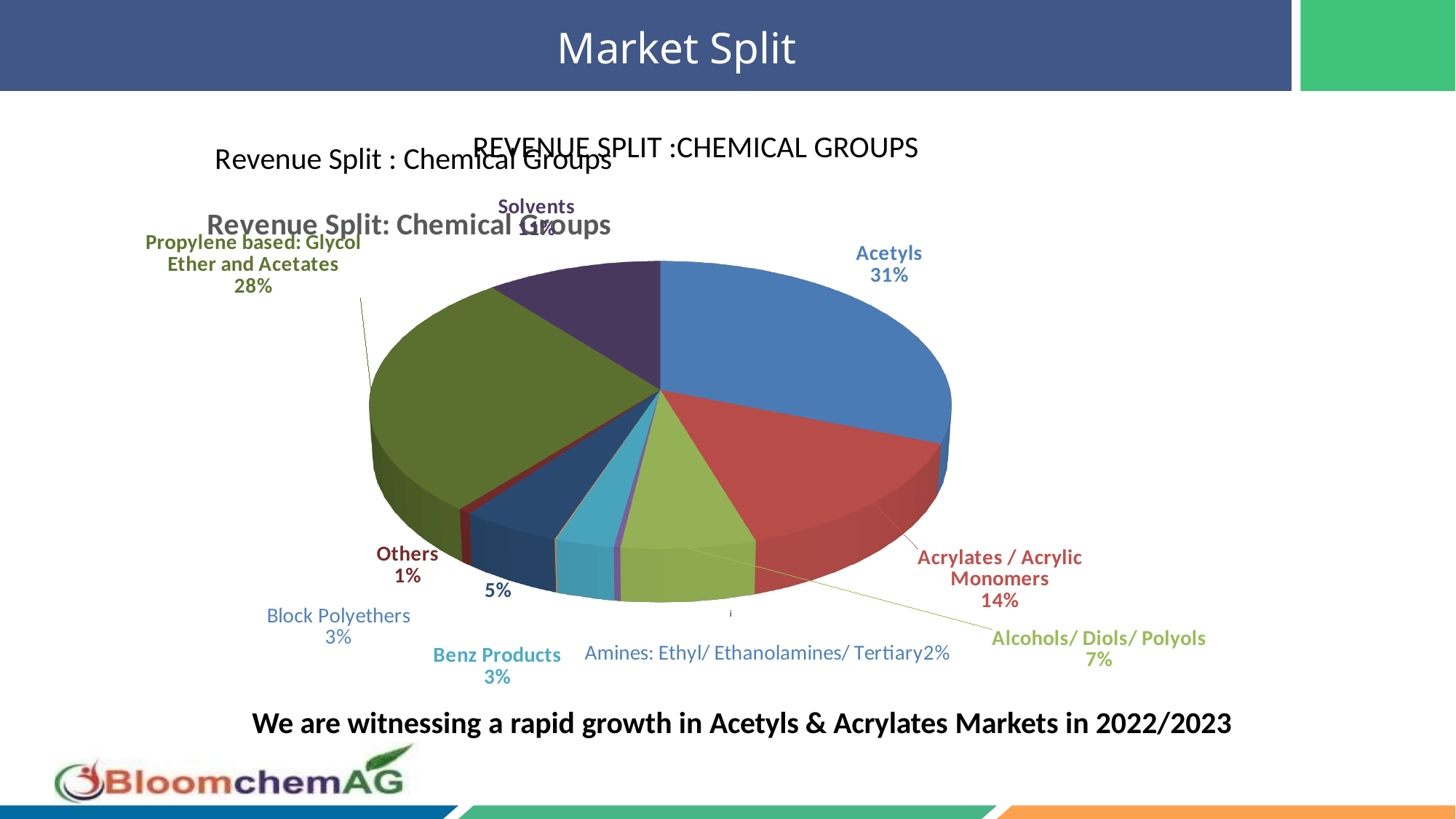
What share does Solvents have in the revenue split? 11% What colour is the Acetyls slice in the pie chart? Blue What share is shown for Alcohols/ Diols/ Polyols? 7% What share of revenue does Acetyls account for in the pie chart? 31% How many percentage points larger is the Acetyls share than the Propylene based: Glycol Ether and Acetates share? 3 percentage points Which has the larger share, Solvents or Alcohols/ Diols/ Polyols? Solvents How many slices does the pie chart have? 10 What percentage is shown for Acrylates / Acrylic Monomers? 14% What type of chart is used to show the revenue split? Pie chart Which chemical group has the largest share of revenue? Acetyls What percentage is shown for Propylene based: Glycol Ether and Acetates? 28%